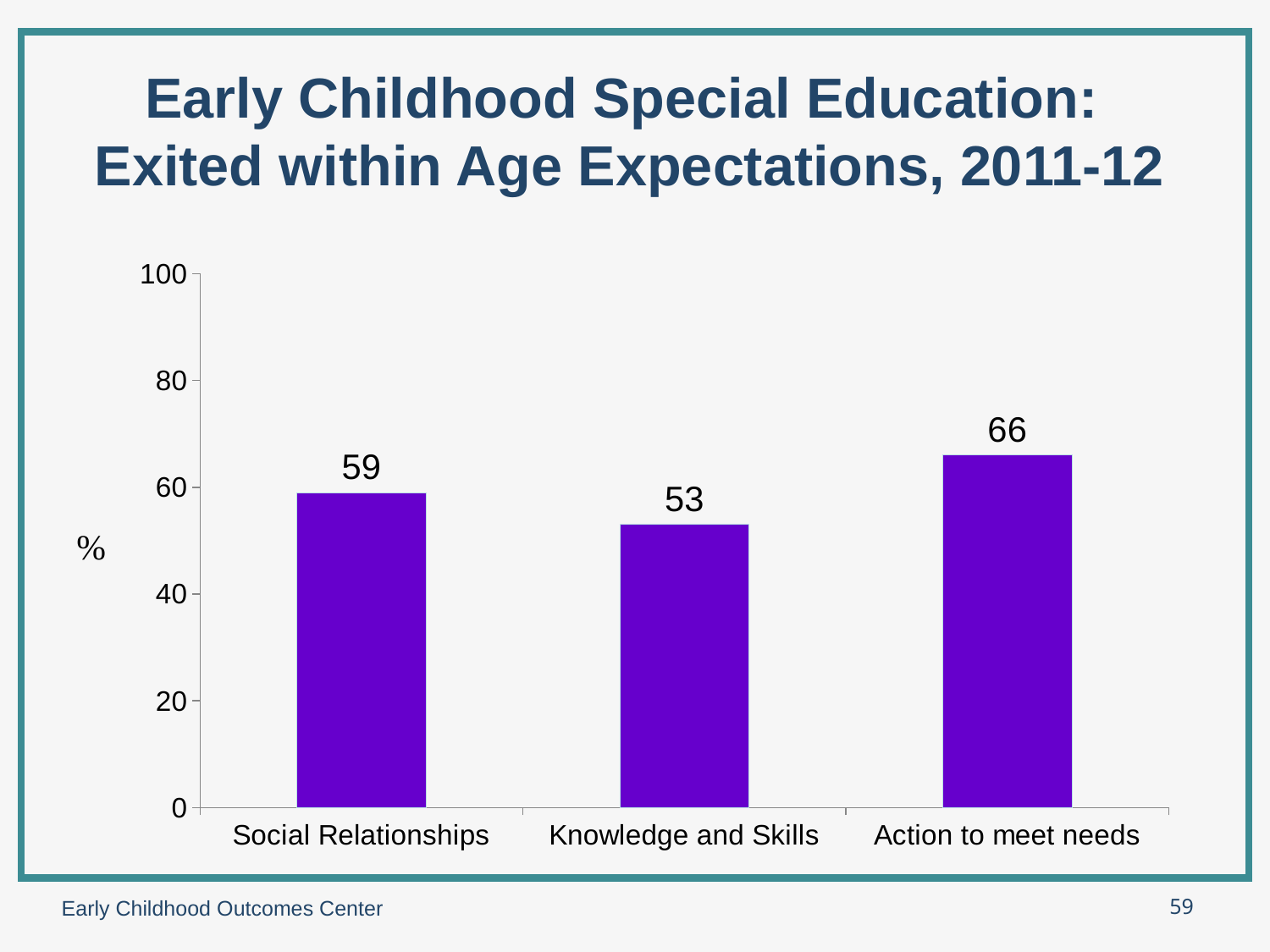
What is the label on the vertical axis of the chart? % What is the value for Knowledge and Skills? 53 How many categories are shown on the chart? 3 Which category has the lowest value? Knowledge and Skills Is the value for Knowledge and Skills greater or less than 60? less What is the difference between the values for Social Relationships and Knowledge and Skills? 6 What is the value for Action to meet needs? 66 Which category has the highest value? Action to meet needs Which is larger, the value for Social Relationships or the value for Action to meet needs? Action to meet needs What is the difference between the values for Action to meet needs and Knowledge and Skills? 13 What kind of chart is shown on the slide? bar chart What is the value for Social Relationships? 59